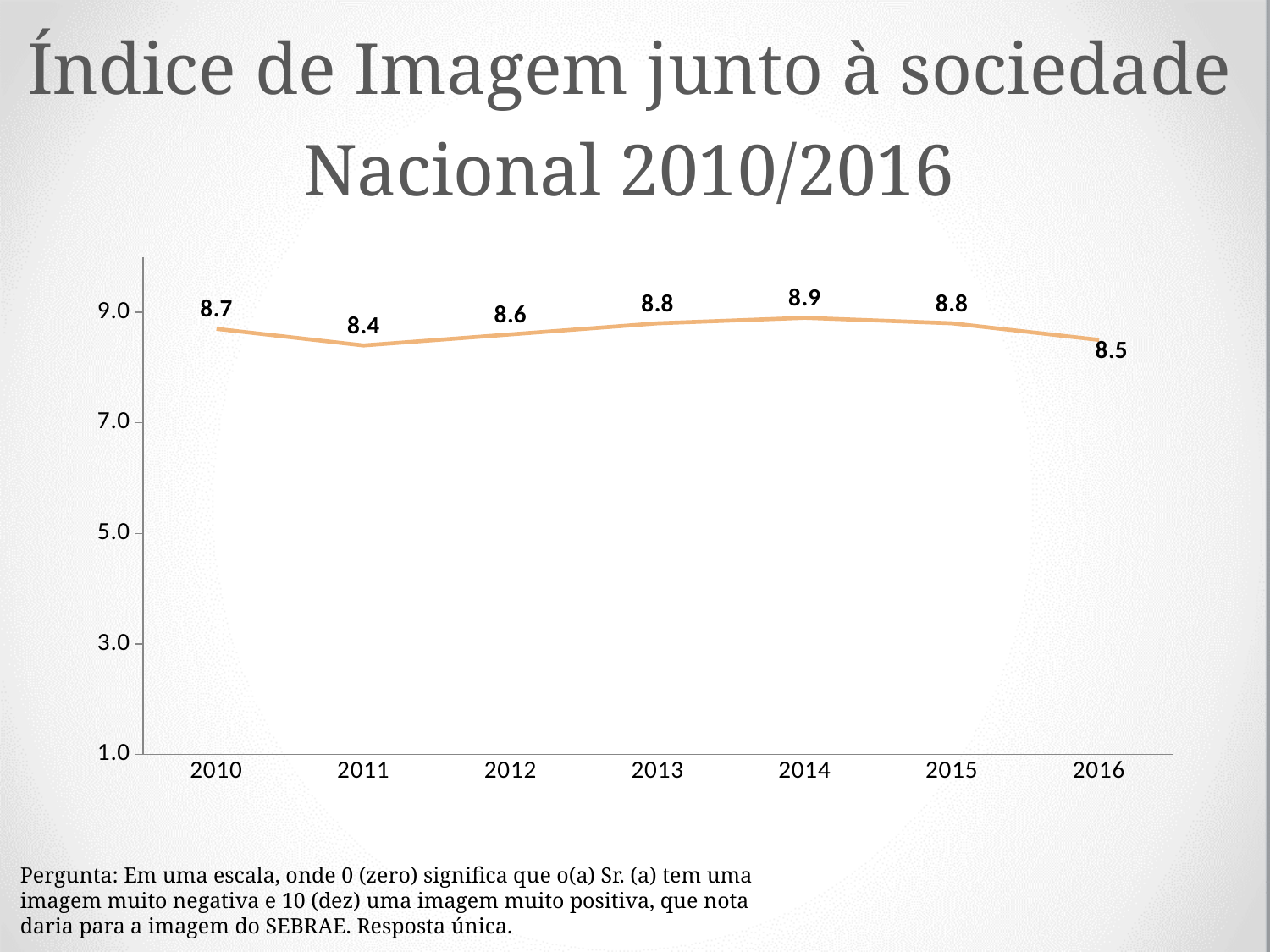
How many years are plotted on the chart? 7 Is the value for 2013 greater or less than 7.0? greater What kind of chart is shown on the slide? line chart Which year has the highest value? 2014 Which year has the lowest value? 2011 What is the value for 2010? 8.7 Does the value rise or fall from 2014 to 2016? fall Which is larger, the value for 2012 or the value for 2016? 2012 What is the title of the chart on the slide? Índice de Imagem junto à sociedade Nacional 2010/2016 What is the value for 2016? 8.5 What is the value for 2014? 8.9 What is the difference between the values for 2014 and 2011? 0.5